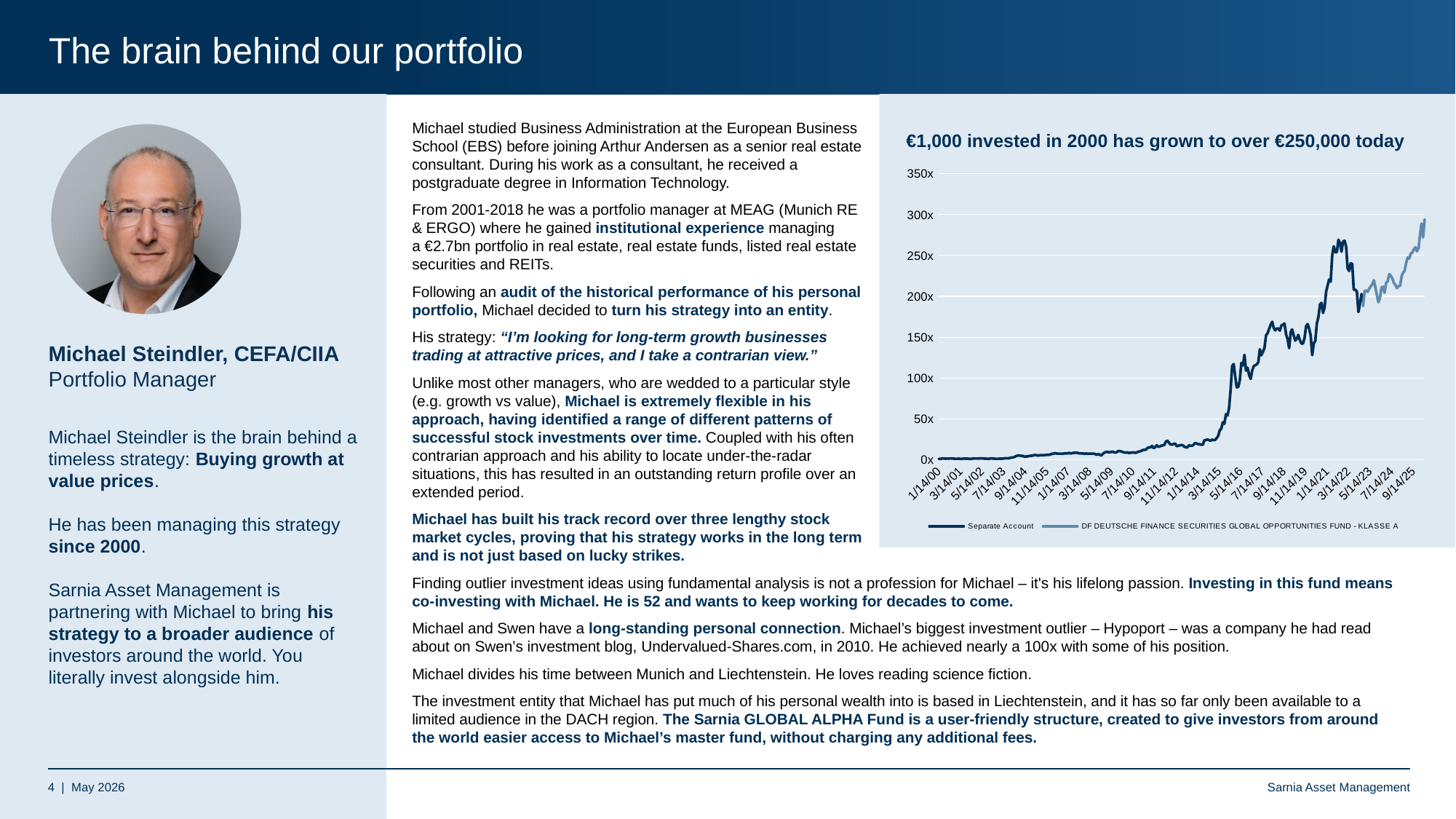
Is the value of the Separate Account line at 7/14/17 greater or less than 100x? greater What is the first date label on the chart's horizontal axis? 1/14/00 Is the value of the line at the right end of the chart (9/14/25) greater or less than 250x? greater Is the value of the Separate Account line at 1/14/00 greater or less than 50x? less What is the name of the first series listed in the chart's legend? Separate Account How many series does the chart's legend list? 2 What is the highest value shown on the chart's vertical axis? 350x Does the Separate Account line generally rise or fall from left to right across the chart? rise What is the title of the chart? €1,000 invested in 2000 has grown to over €250,000 today What kind of chart is shown on the slide? line chart What is the last date label on the chart's horizontal axis? 9/14/25